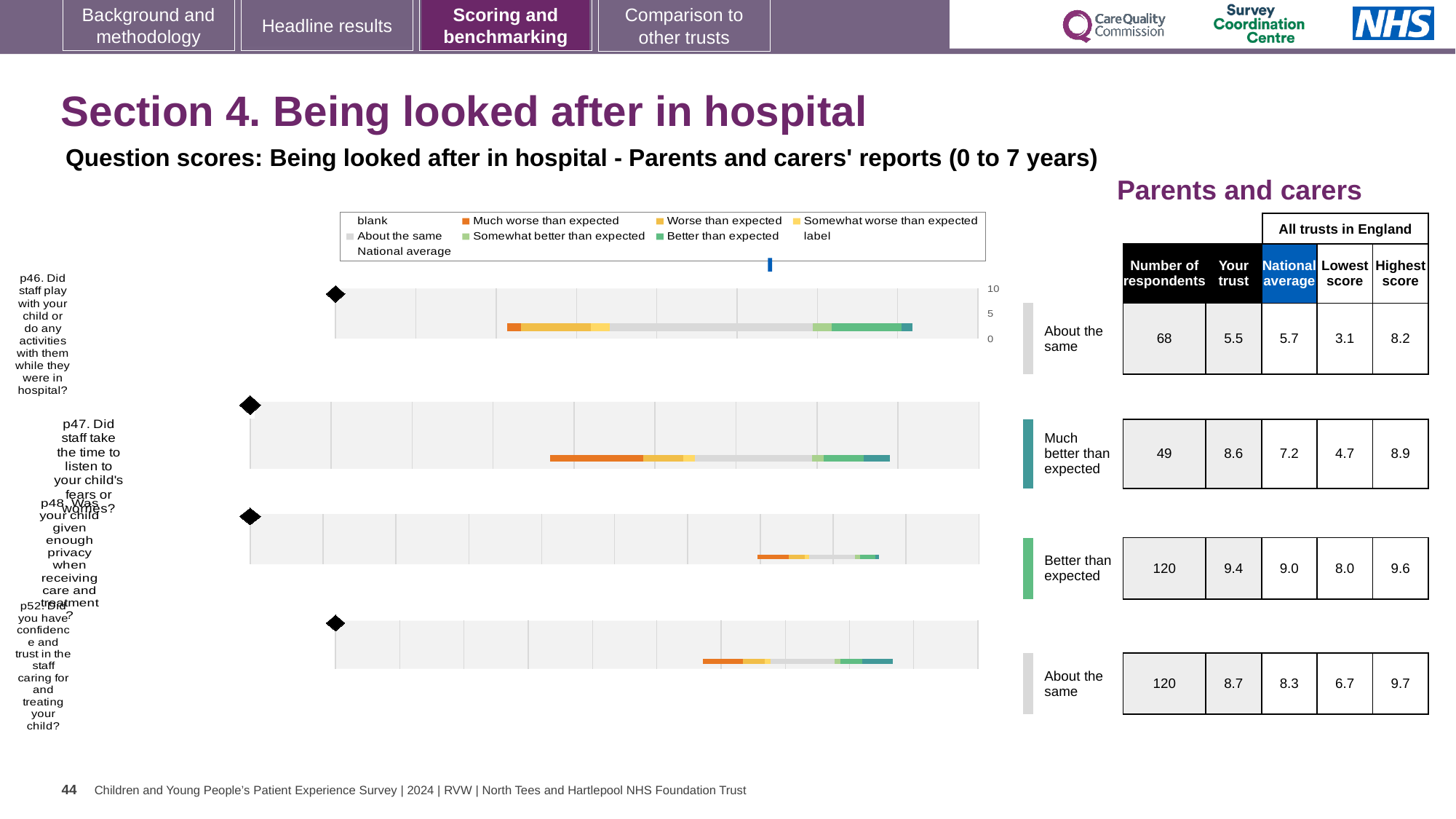
What is the national average score for p47? 7.2 What kind of chart is used to show the question scores on this slide? bar chart How many respondents answered p48? 120 What is the 'Your trust' score for p46 (Did staff play with your child or do any activities with them while they were in hospital)? 5.5 Which of the four questions has the lowest 'Your trust' score? p46 Which of the four questions has the highest 'Your trust' score? p48 How many survey questions (rows) are plotted in the chart? 4 For p52, is the 'Your trust' score or the national average higher? Your trust What is the highest score among all trusts in England for p52? 9.7 What is the difference between the 'Your trust' score and the national average for p47? 1.4 Which benchmark category is shown for p47 (Did staff take the time to listen to your child's fears or worries)? Much better than expected Which benchmark category is shown for p48 (Was your child given enough privacy when receiving care and treatment)? Better than expected